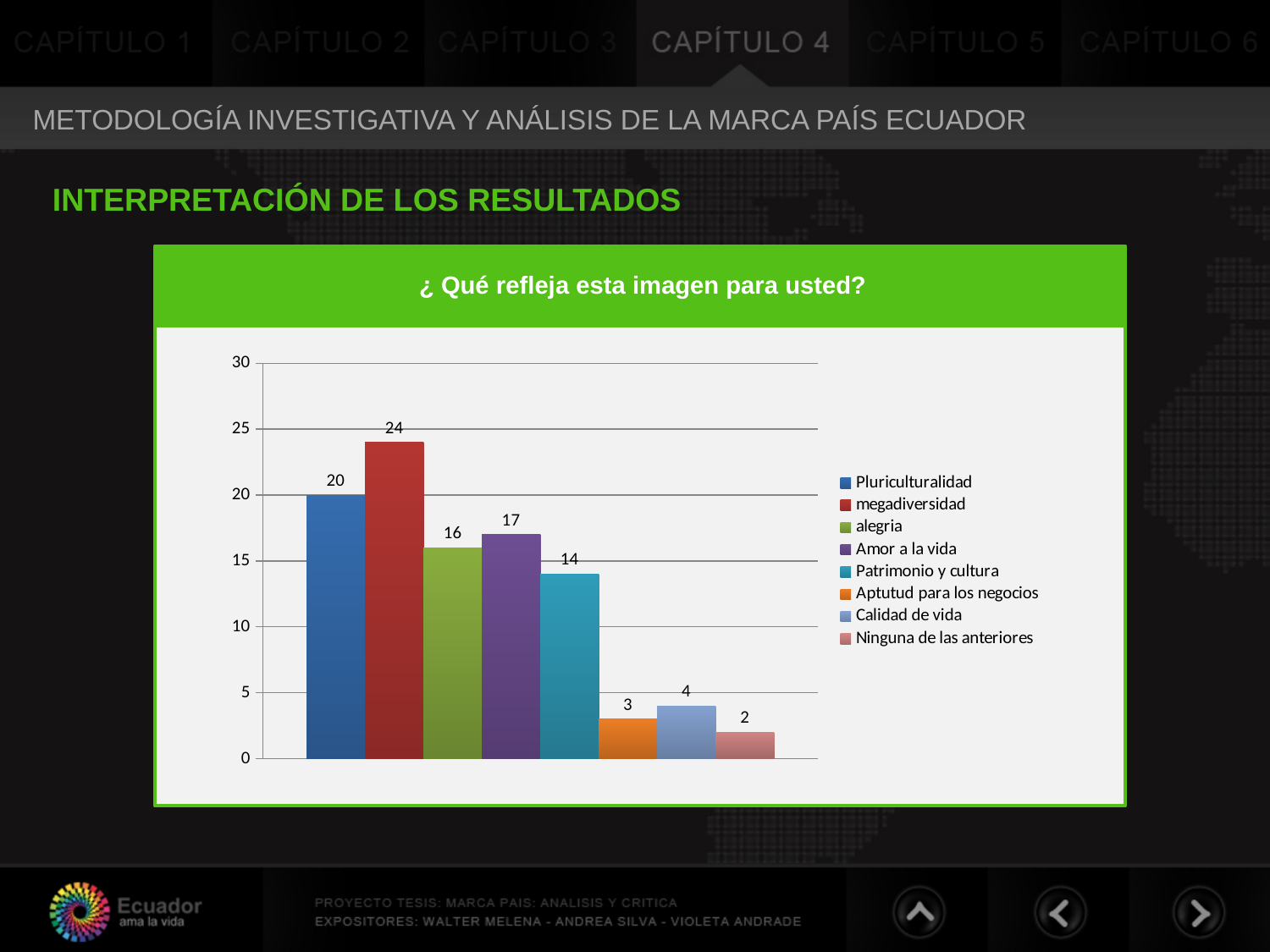
Which is larger, the value for alegria or the value for Amor a la vida? Amor a la vida How many categories does the legend list? 8 What is the difference between the values for megadiversidad and Pluriculturalidad? 4 What is the difference between the values for Calidad de vida and Ninguna de las anteriores? 2 What is the value for Patrimonio y cultura? 14 What is the value for megadiversidad? 24 What kind of chart is shown on the slide? bar chart Which category has the lowest value? Ninguna de las anteriores Which category has the highest value? megadiversidad Is the value for Calidad de vida greater or less than 5? less What is the value for Aptutud para los negocios? 3 What is the title of the chart? ¿ Qué refleja esta imagen para usted?